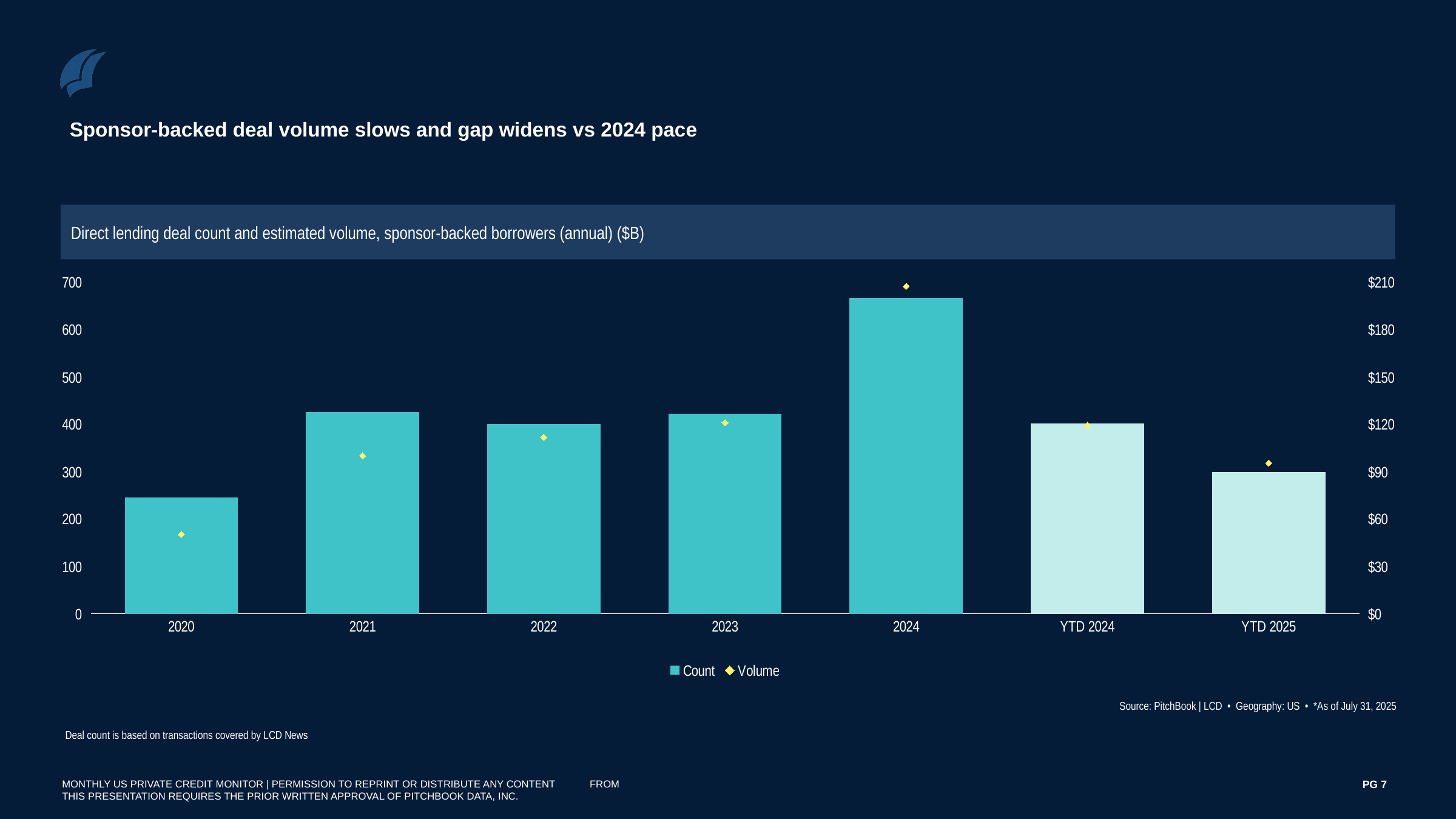
How many categories are shown along the x axis? 7 Is the deal count for 2020 greater or less than 300? less Is the deal count for YTD 2025 greater or less than 400? less How many series does the legend list? 2 Which has the larger volume, 2020 or 2021? 2021 Which category has the lowest deal count bar? 2020 Is the volume for 2024 greater or less than $180? greater What are the two series named in the legend? Count and Volume Which has the larger deal count, YTD 2024 or YTD 2025? YTD 2024 Which category has the highest deal count bar? 2024 What kind of chart is shown on the slide? bar chart